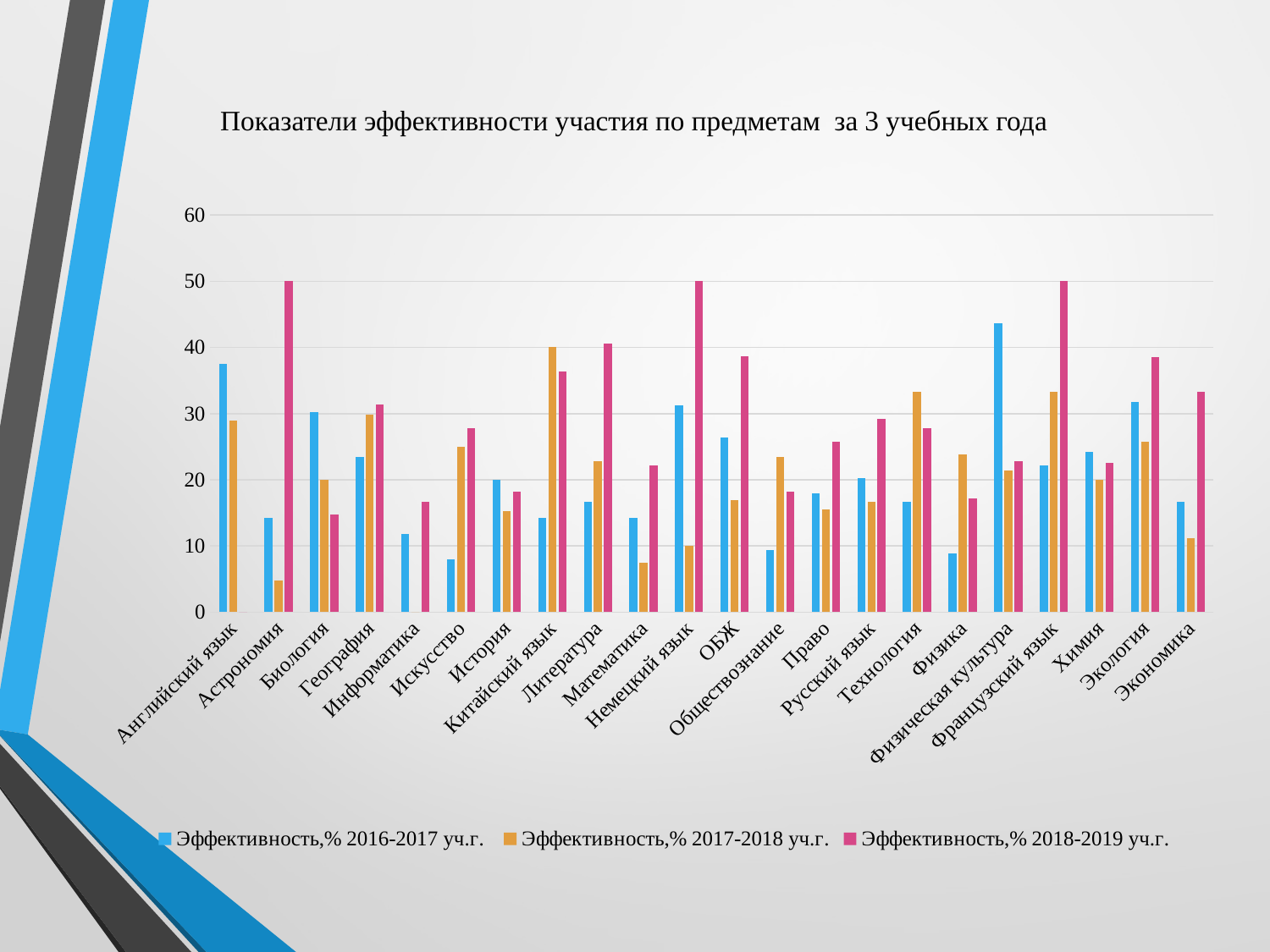
Is the value for Астрономия in the series Эффективность,% 2018-2019 уч.г. greater or less than 40? greater Is the value for Немецкий язык in the series Эффективность,% 2017-2018 уч.г. greater or less than 20? less How many subject categories are shown on the x axis? 22 Is the value for Астрономия in the series Эффективность,% 2017-2018 уч.г. greater or less than 10? less How many series does the legend list? 3 Which subject has the highest value for the series Эффективность,% 2016-2017 уч.г.? Физическая культура For Английский язык, which series has the larger value: Эффективность,% 2016-2017 уч.г. or Эффективность,% 2017-2018 уч.г.? Эффективность,% 2016-2017 уч.г. Which subject has the highest value for the series Эффективность,% 2017-2018 уч.г.? Китайский язык What is the title of the chart? Показатели эффективности участия по предметам за 3 учебных года What kind of chart is shown on the slide? bar chart For Литература, which series has the larger value: Эффективность,% 2017-2018 уч.г. or Эффективность,% 2018-2019 уч.г.? Эффективность,% 2018-2019 уч.г.